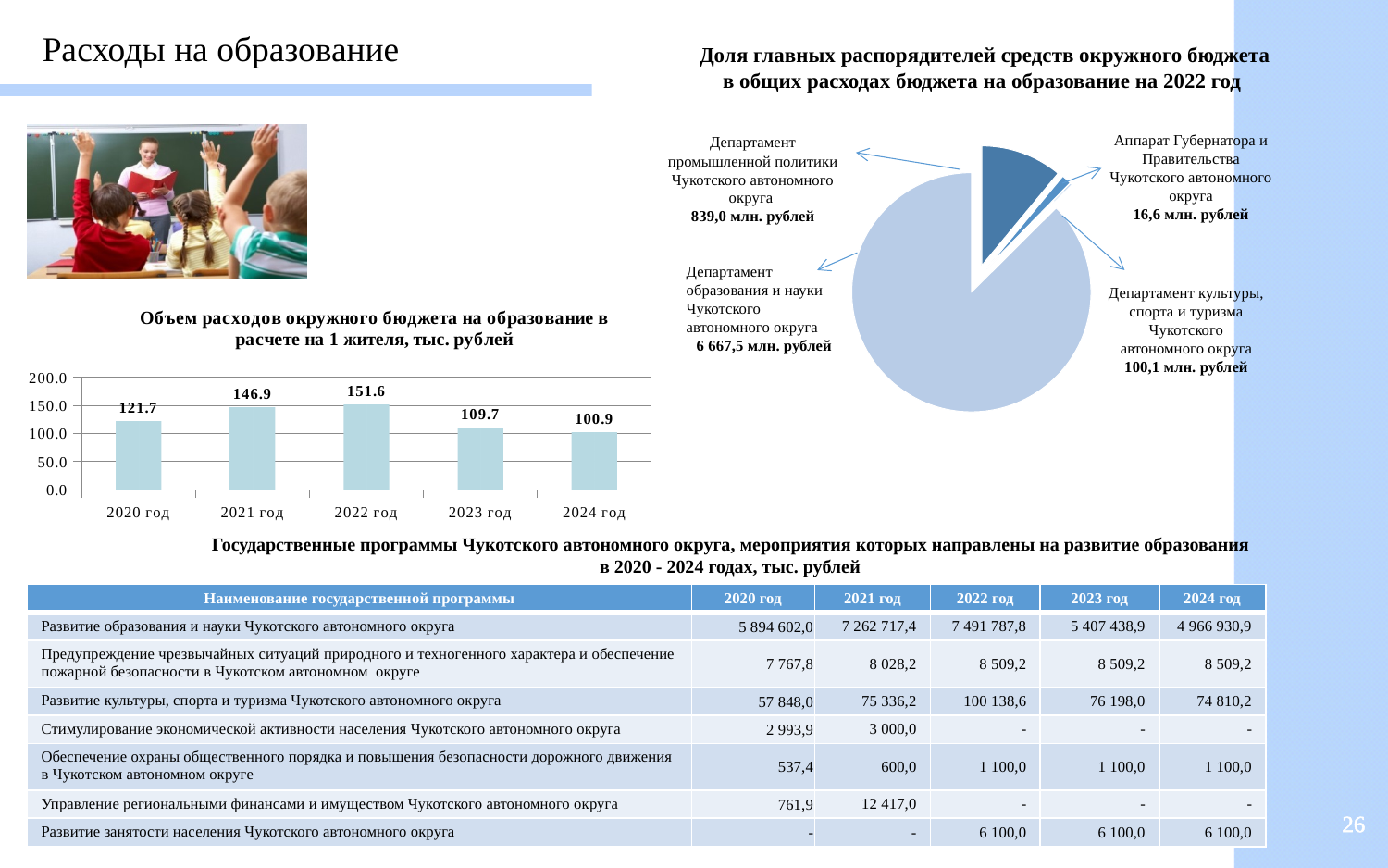
On the bar chart 'Объем расходов окружного бюджета на образование в расчете на 1 жителя', what is the value for 2022 год? 151.6 On the bar chart 'Объем расходов окружного бюджета на образование в расчете на 1 жителя', which year has the highest value? 2022 год On the bar chart 'Объем расходов окружного бюджета на образование в расчете на 1 жителя', which year has the lowest value? 2024 год On the bar chart 'Объем расходов окружного бюджета на образование в расчете на 1 жителя', do the values rise or fall from 2022 год to 2024 год? fall On the bar chart 'Объем расходов окружного бюджета на образование в расчете на 1 жителя', how many years are shown? 5 On the pie chart 'Доля главных распорядителей средств окружного бюджета в общих расходах бюджета на образование на 2022 год', what is the value for Аппарат Губернатора и Правительства Чукотского автономного округа? 16,6 млн. рублей On the bar chart 'Объем расходов окружного бюджета на образование в расчете на 1 жителя', what is the value for 2024 год? 100.9 On the bar chart 'Объем расходов окружного бюджета на образование в расчете на 1 жителя', which is larger: the value for 2020 год or 2021 год? 2021 год On the pie chart 'Доля главных распорядителей средств окружного бюджета в общих расходах бюджета на образование на 2022 год', which is larger: Департамент промышленной политики or Департамент культуры, спорта и туризма? Департамент промышленной политики On the bar chart 'Объем расходов окружного бюджета на образование в расчете на 1 жителя', what is the difference between the values for 2022 год and 2023 год? 41.9 On the pie chart 'Доля главных распорядителей средств окружного бюджета в общих расходах бюджета на образование на 2022 год', what is the value for Департамент образования и науки Чукотского автономного округа? 6 667,5 млн. рублей What kind of chart is 'Объем расходов окружного бюджета на образование в расчете на 1 жителя'? bar chart